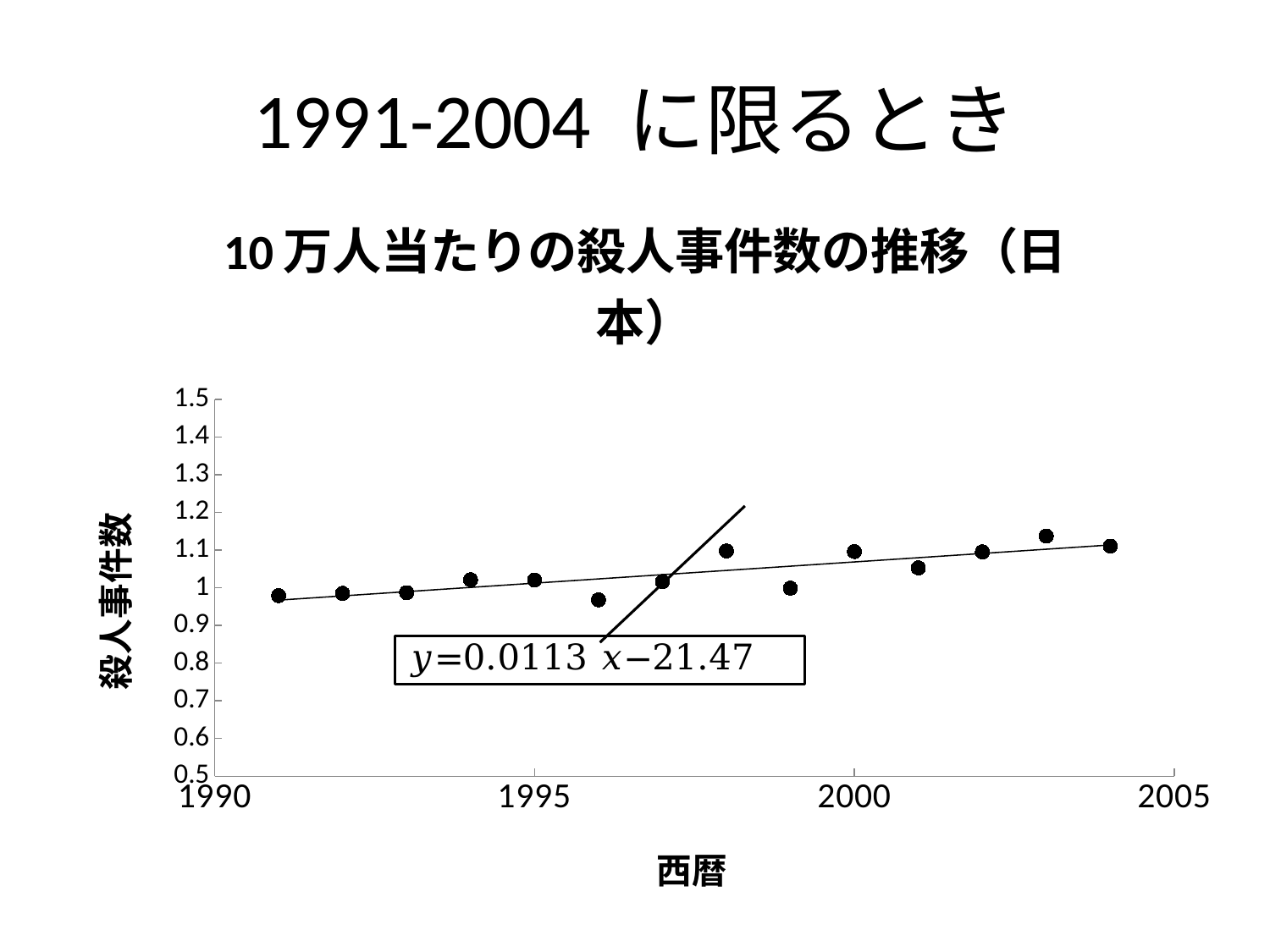
Which is larger, the value for 1998 or the value for 1996? 1998 What is the label of the x axis? 西暦 What kind of chart is shown on the slide? scatter chart How many data points are plotted in the chart? 14 Is the value for 1991 greater or less than 1.1? less Do the values generally rise or fall from 1991 to 2004 according to the trend line? rise Is the value for 2001 greater or less than 1? greater Which year has the highest value in the chart? 2003 What is the title of the chart? 10万人当たりの殺人事件数の推移（日本） Which is larger, the value for 1992 or the value for 2000? 2000 Is the value for 1996 greater or less than 1.1? less